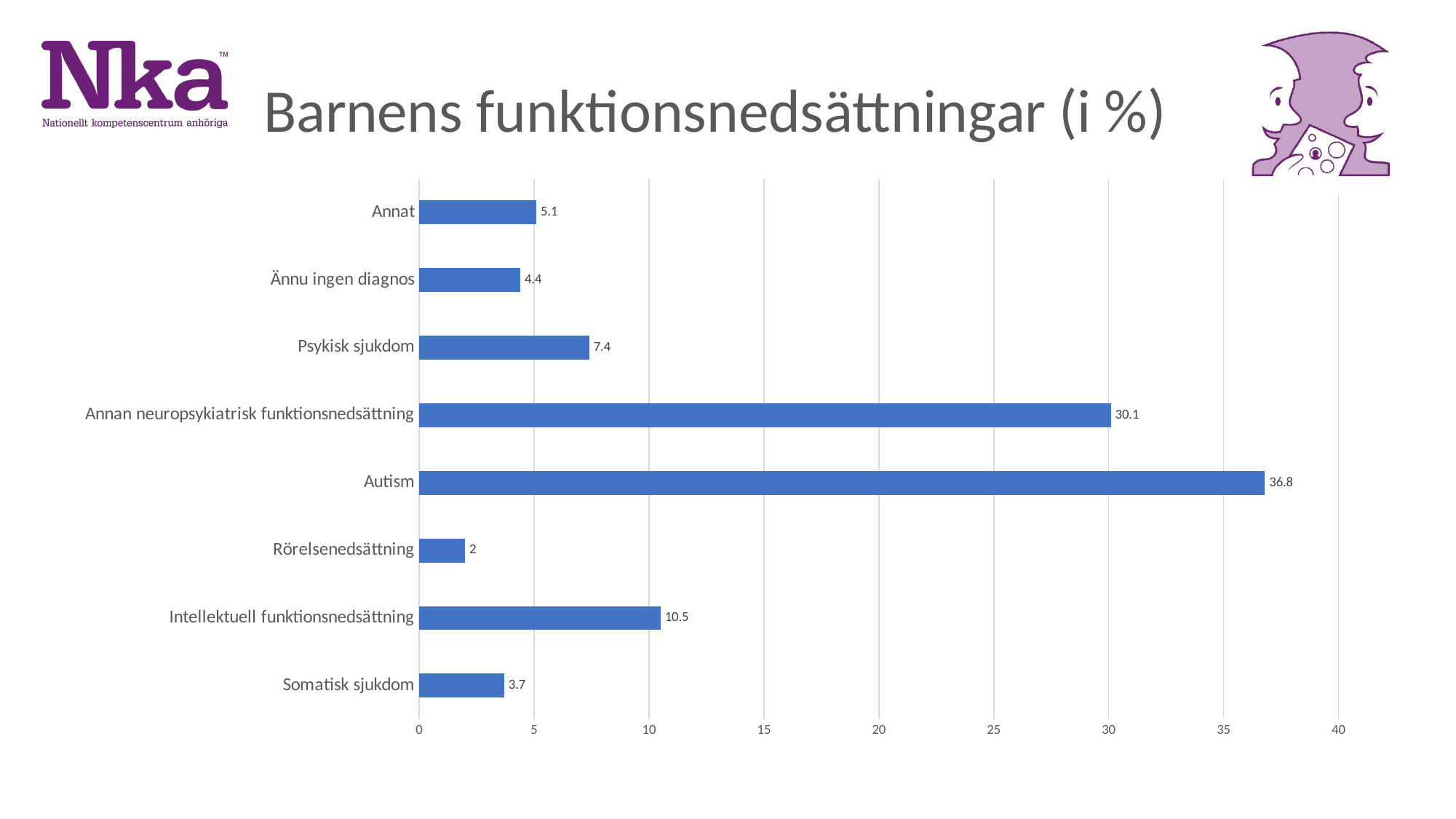
What is the value for Autism? 36.8 How many categories are shown in the chart? 8 Which category has the lowest value? Rörelsenedsättning What is the difference between the values for Autism and Annan neuropsykiatrisk funktionsnedsättning? 6.7 Which category has the highest value? Autism What is the value for Rörelsenedsättning? 2 What kind of chart is shown on the slide? bar chart What is the difference between the values for Annat and Somatisk sjukdom? 1.4 What is the title of the slide? Barnens funktionsnedsättningar (i %) What is the value for Intellektuell funktionsnedsättning? 10.5 Which is larger, the value for Psykisk sjukdom or the value for Annat? Psykisk sjukdom Is the value for Annan neuropsykiatrisk funktionsnedsättning greater or less than 25? greater